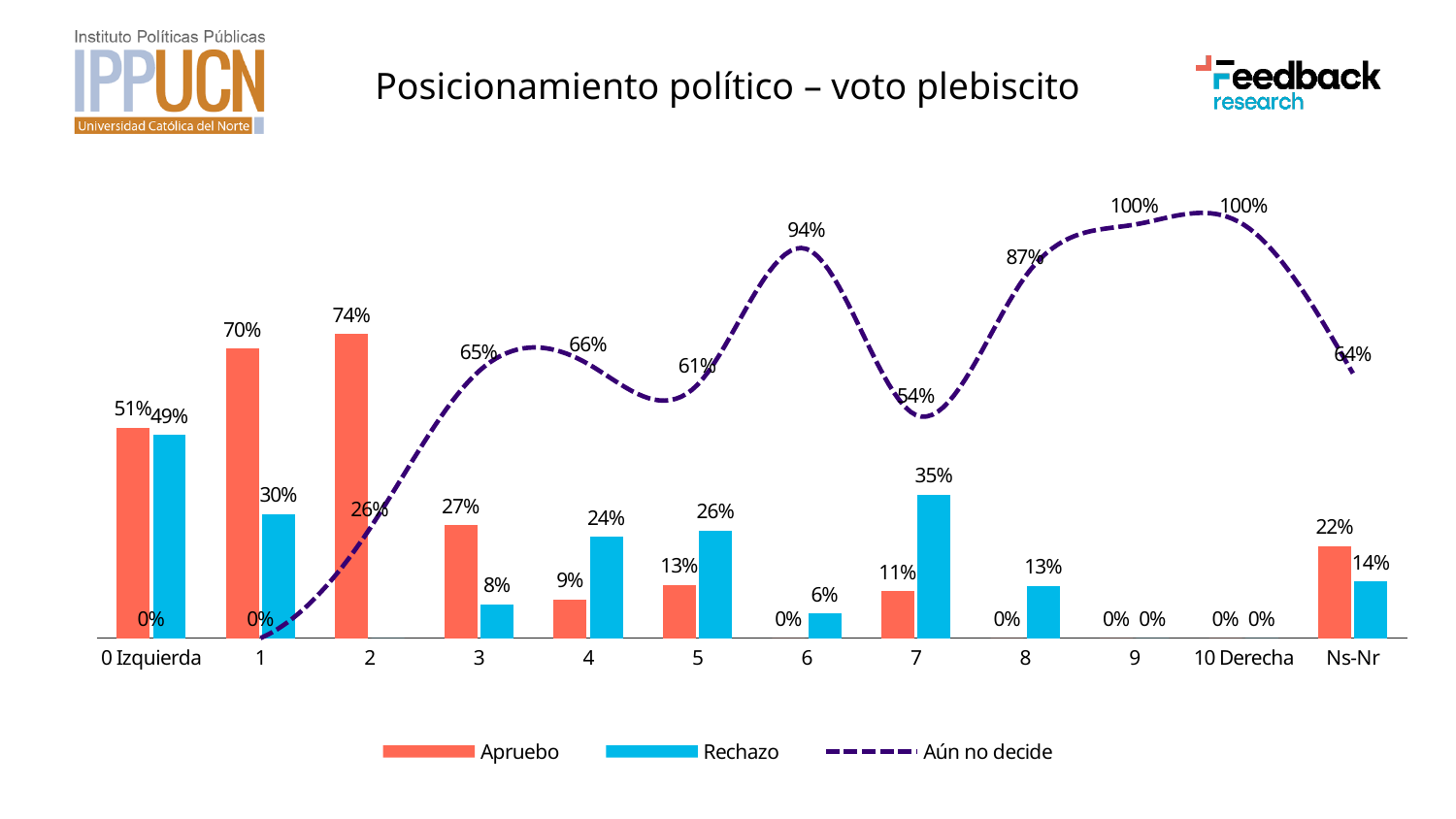
What is the difference between the Apruebo and Rechazo values for category 1? 40% How many series does the legend list? 3 Which is larger for category 4, Apruebo or Rechazo? Rechazo What is the Apruebo value for category 2? 74% What is the Aún no decide value for category 6? 94% What is the title of the chart? Posicionamiento político – voto plebiscito Which category has the highest Rechazo value? 7 What is the Apruebo value for Ns-Nr? 22% Which category has the highest Apruebo value? 2 What type of chart is used for the Apruebo and Rechazo series? Bar chart How many categories are shown on the x axis? 12 What is the Rechazo value for category 7? 35%